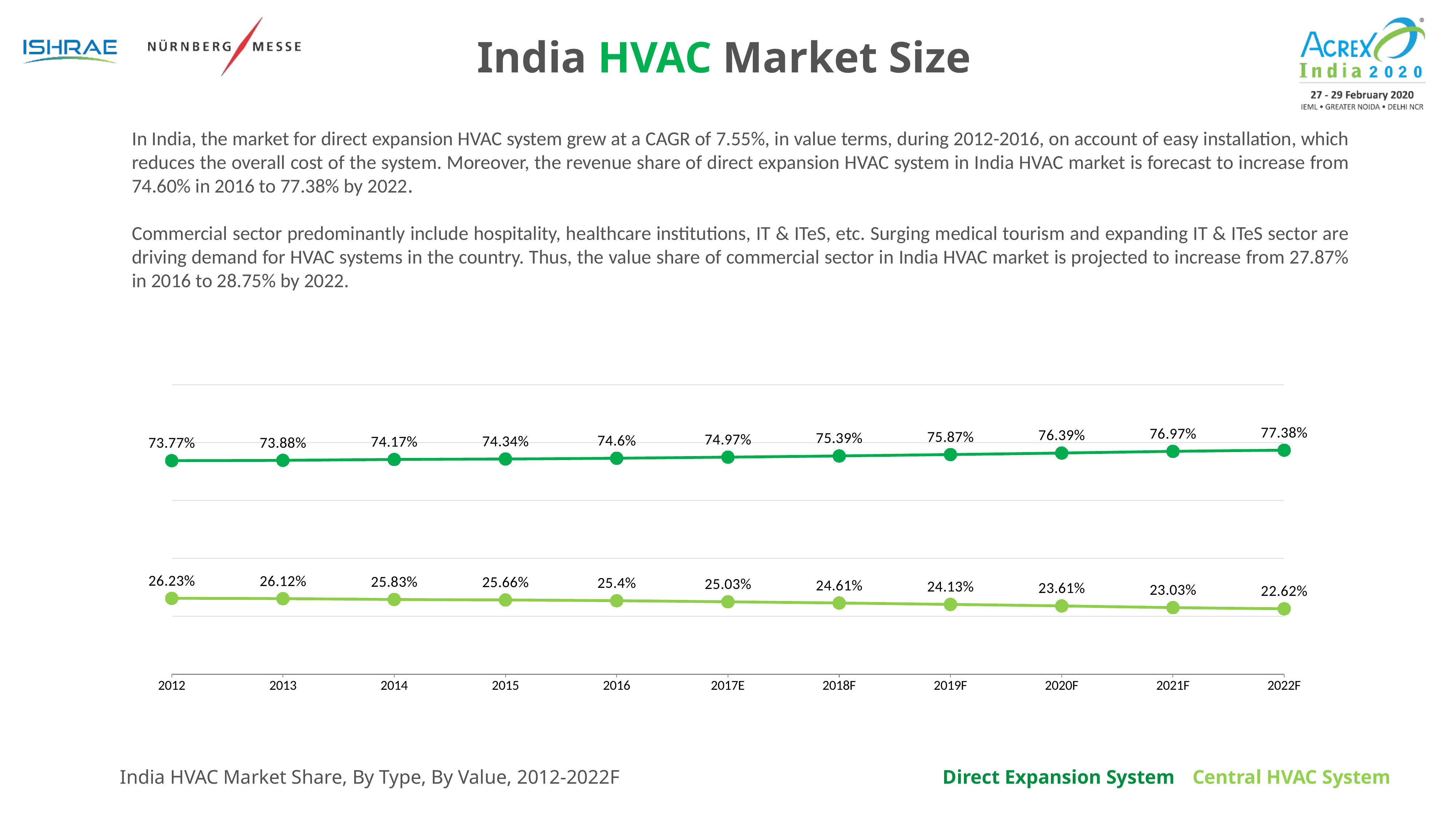
Does the Central HVAC System share rise or fall from 2012 to 2022F? Fall How many years are shown on the x axis? 11 What is the value for Central HVAC System in 2019F? 24.13% What is the title of the chart? India HVAC Market Share, By Type, By Value, 2012-2022F How many series does the legend list? 2 What is the value for Direct Expansion System in 2016? 74.6% Which is larger in 2018F: the Direct Expansion System share or the Central HVAC System share? Direct Expansion System What is the value for Direct Expansion System in 2022F? 77.38% What type of chart is shown on the slide? Line chart What is the difference between the Direct Expansion System share in 2022F and in 2012? 3.61% In which year is the Central HVAC System share highest? 2012 In which year is the Direct Expansion System share lowest? 2012